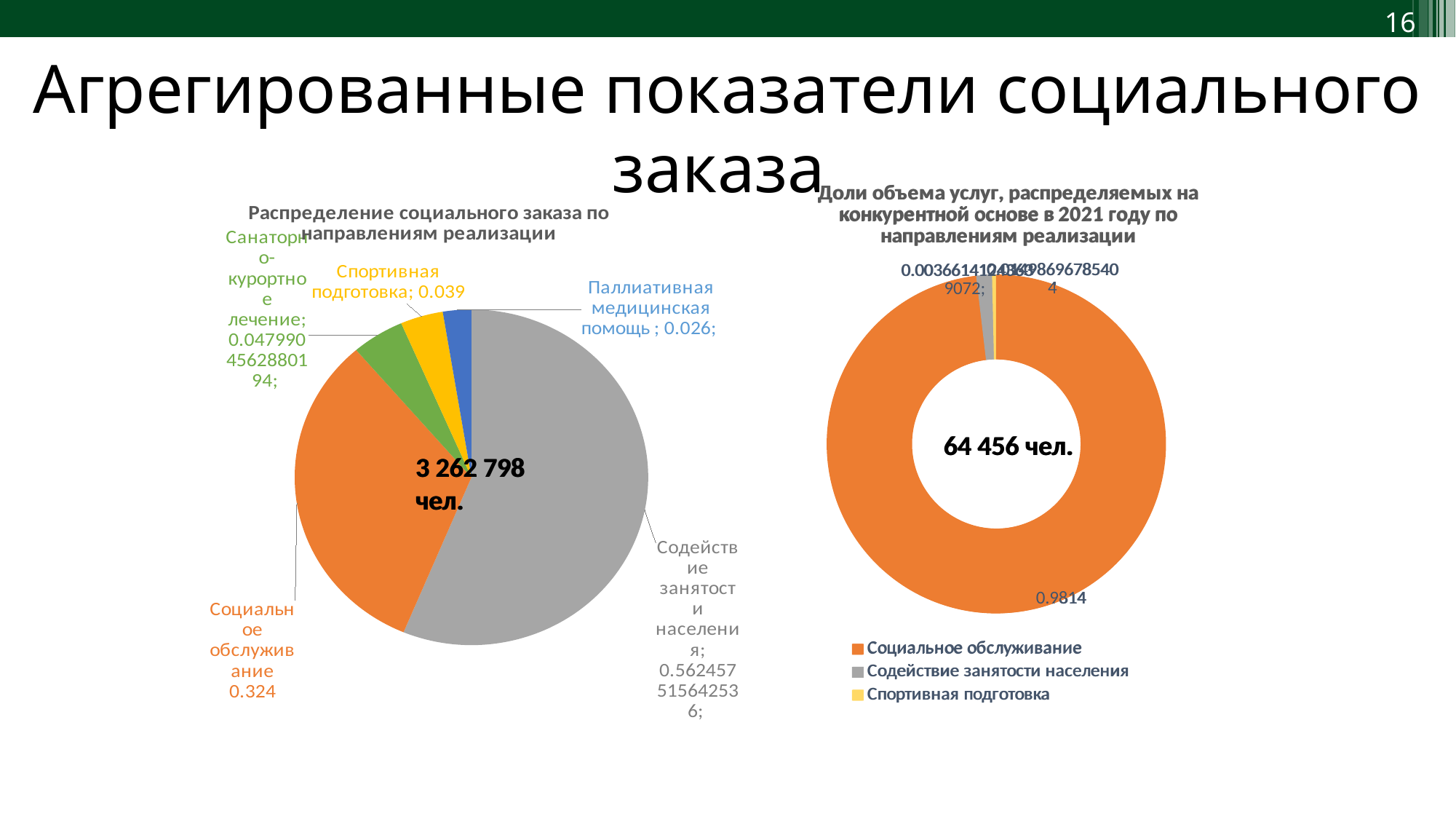
In the left chart 'Распределение социального заказа по направлениям реализации', what is the value for Спортивная подготовка? 0.039 How many entries does the legend of the right chart 'Доли объема услуг, распределяемых на конкурентной основе в 2021 году по направлениям реализации' list? 3 In the left chart 'Распределение социального заказа по направлениям реализации', which category has the smallest slice? Паллиативная медицинская помощь How many categories are shown in the left chart 'Распределение социального заказа по направлениям реализации'? 5 What total number of people is shown in the centre of the right chart 'Доли объема услуг, распределяемых на конкурентной основе в 2021 году по направлениям реализации'? 64 456 чел. In the left chart 'Распределение социального заказа по направлениям реализации', which is larger: Социальное обслуживание or Спортивная подготовка? Социальное обслуживание In the left chart 'Распределение социального заказа по направлениям реализации', what is the difference between the values for Спортивная подготовка and Паллиативная медицинская помощь? 0.013 In the right chart 'Доли объема услуг, распределяемых на конкурентной основе в 2021 году по направлениям реализации', what is the value for Социальное обслуживание? 0.9814 In the left chart 'Распределение социального заказа по направлениям реализации', which category has the largest slice? Содействие занятости населения What kind of chart is the left chart 'Распределение социального заказа по направлениям реализации'? Pie chart In the left chart 'Распределение социального заказа по направлениям реализации', what is the value for Паллиативная медицинская помощь? 0.026 In the left chart 'Распределение социального заказа по направлениям реализации', what is the value for Социальное обслуживание? 0.324